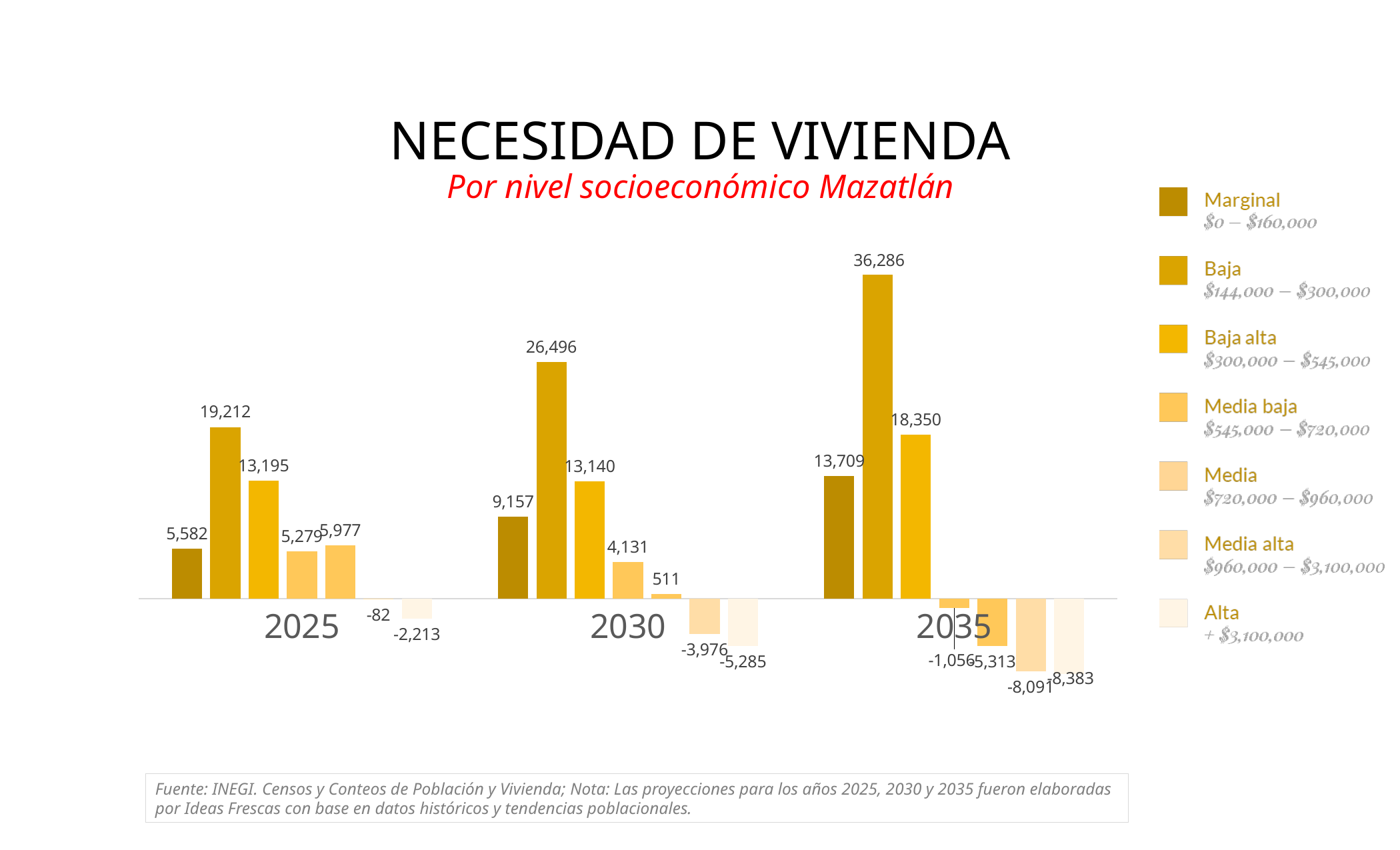
Which socioeconomic level has the lowest value in 2030? Alta In 2030, which is larger: Media baja or Media? Media baja How many series does the legend list? 7 Which socioeconomic level has the highest value in 2025? Baja What is the value for Marginal in 2030? 9,157 Does the value for Baja rise or fall from 2025 to 2035? rise How many years are shown on the x axis? 3 What is the difference between the Marginal values for 2035 and 2025? 8,127 What is the value for Baja in 2035? 36,286 What is the difference between the Baja values for 2030 and 2025? 7,284 What is the value for Alta in 2030? -5,285 What is the value for Media in 2030? 511